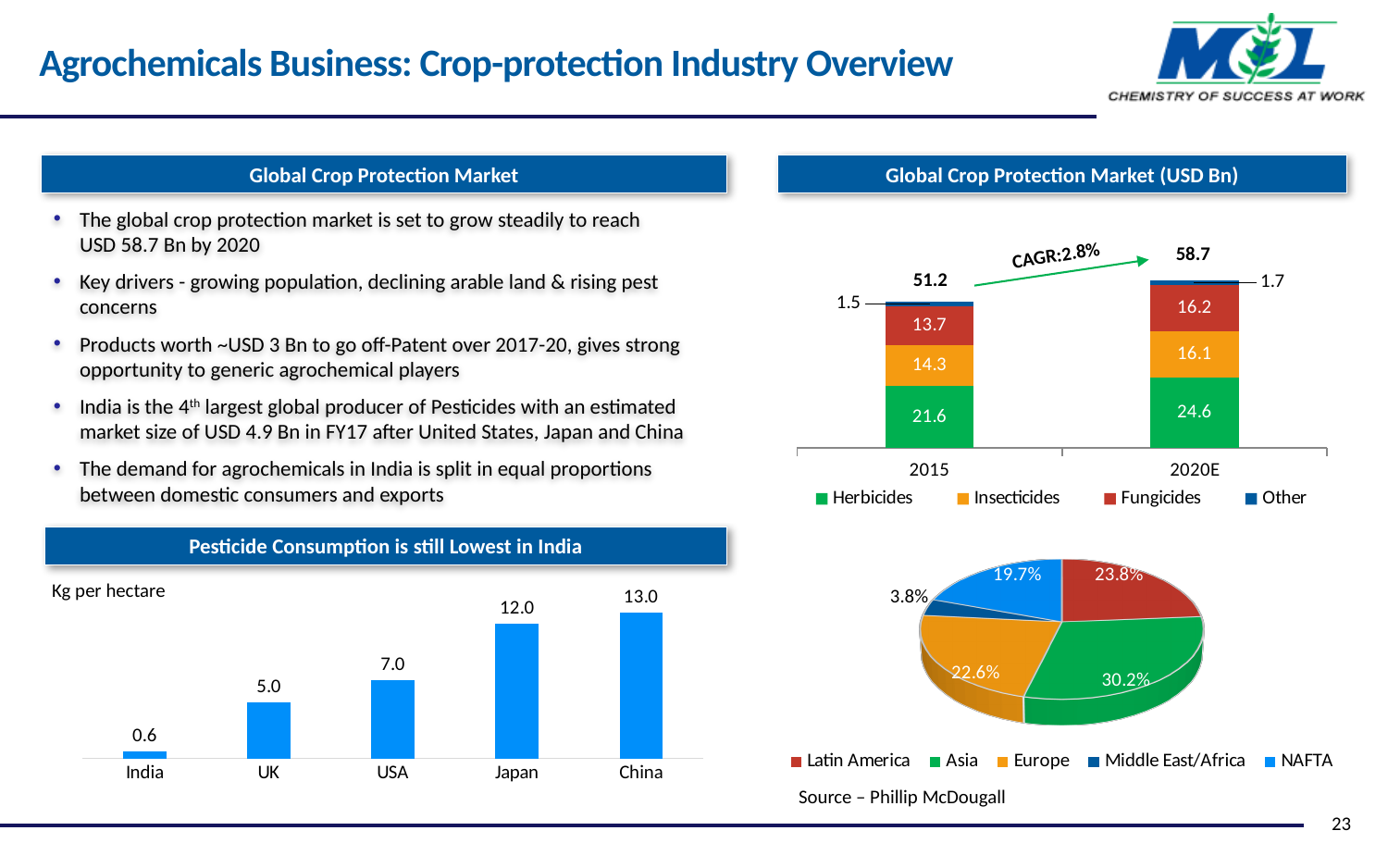
In the 'Pesticide Consumption is still Lowest in India' chart, which country has the highest value? China In the 'Pesticide Consumption is still Lowest in India' chart, which country has the lowest value? India In the 'Global Crop Protection Market (USD Bn)' chart, what is the Herbicides value for 2020E? 24.6 In the 'Global Crop Protection Market (USD Bn)' chart, what is the total for 2015? 51.2 In the pie chart at the bottom right of the slide, what share does Asia have? 30.2% In the 'Pesticide Consumption is still Lowest in India' chart, how many countries are shown? 5 In the 'Pesticide Consumption is still Lowest in India' chart, what is the value for USA? 7.0 In the 'Pesticide Consumption is still Lowest in India' chart, what is the difference between the values for Japan and UK? 7.0 In the pie chart at the bottom right of the slide, which region has the smallest share? Middle East/Africa What kind of chart is 'Pesticide Consumption is still Lowest in India'? Bar chart In the 'Global Crop Protection Market (USD Bn)' chart, is the Fungicides value larger in 2015 or 2020E? 2020E In the 'Global Crop Protection Market (USD Bn)' chart, how many series does the legend list? 4